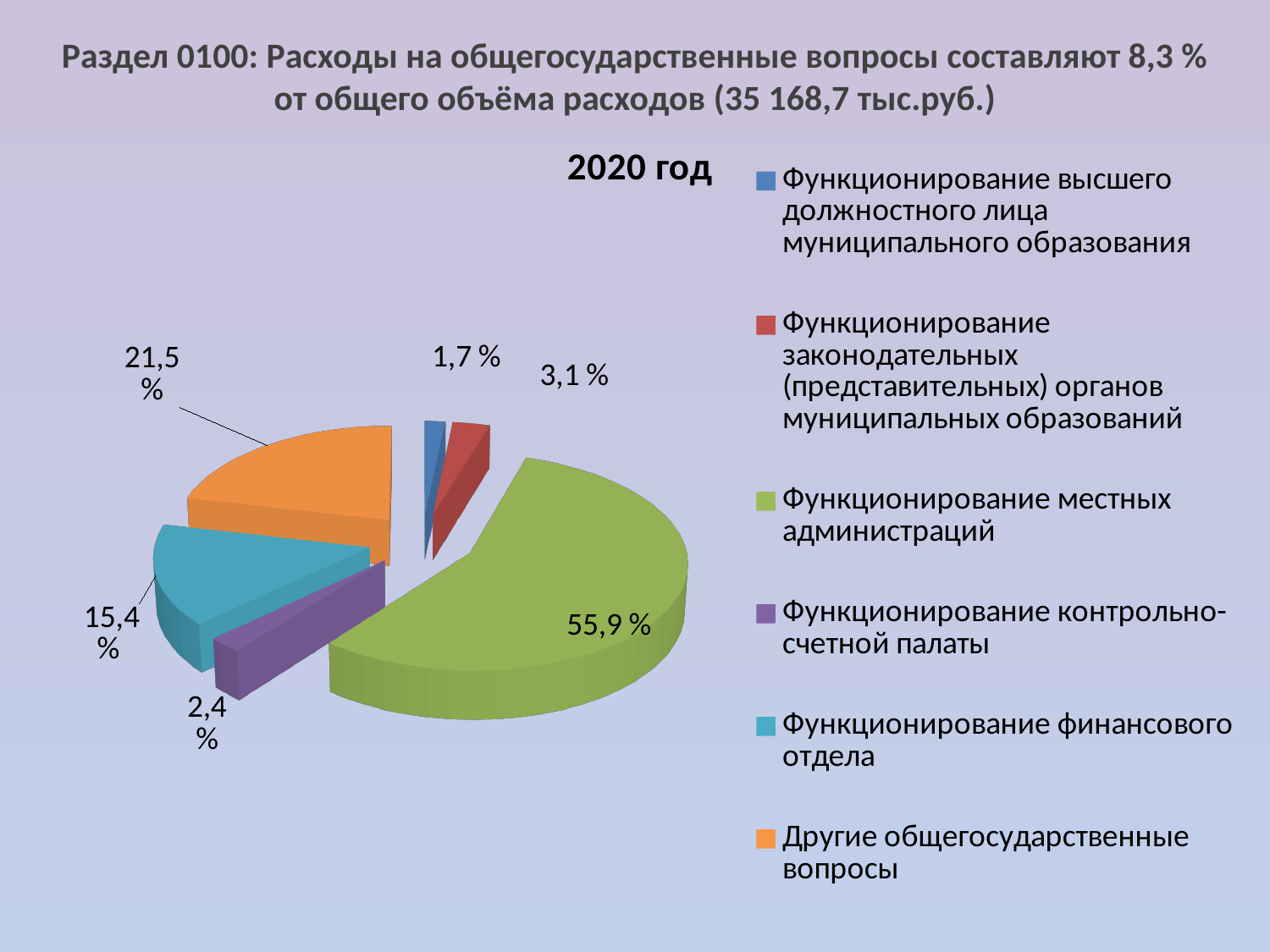
Какой тип диаграммы показан на слайде? Круговая диаграмма Какая категория имеет наименьшую долю на диаграмме? Функционирование высшего должностного лица муниципального образования Какая доля приходится на «Функционирование высшего должностного лица муниципального образования»? 1,7 % Какая доля приходится на «Другие общегосударственные вопросы»? 21,5 % Какой год указан в заголовке диаграммы? 2020 год Какая доля приходится на «Функционирование контрольно-счетной палаты»? 2,4 % На сколько процентных пунктов доля «Другие общегосударственные вопросы» больше доли «Функционирование финансового отдела»? 6,1 Какая доля приходится на «Функционирование финансового отдела»? 15,4 % Сколько категорий перечислено в легенде диаграммы? 6 Какая категория имеет наибольшую долю на диаграмме? Функционирование местных администраций Что больше: доля «Функционирование законодательных (представительных) органов муниципальных образований» или доля «Функционирование контрольно-счетной палаты»? Функционирование законодательных (представительных) органов муниципальных образований Какая доля приходится на «Функционирование местных администраций»? 55,9 %